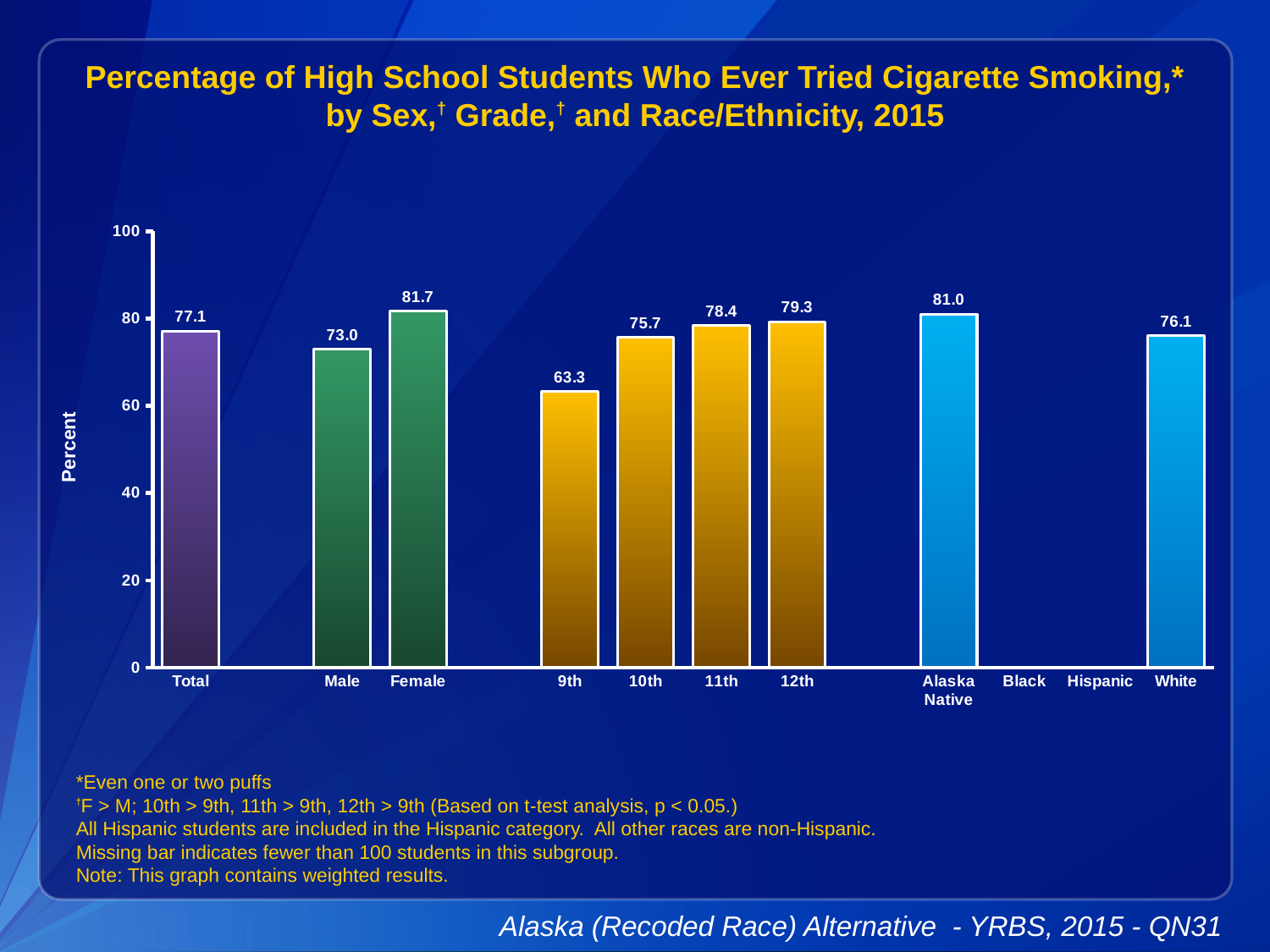
Which category has the highest value? Female What is the value for 9th grade? 63.3 What kind of chart is shown? bar chart Which is larger, the value for 12th grade or the value for 10th grade? 12th What is the difference between the Female and Male values? 8.7 How many bars are plotted on the chart? 9 What is the value for Alaska Native? 81.0 Do the values rise or fall from 9th grade to 12th grade? rise Which category has the lowest value? 9th Is the value for White greater or less than 80? less What is the value for Female? 81.7 What is the value for Total? 77.1